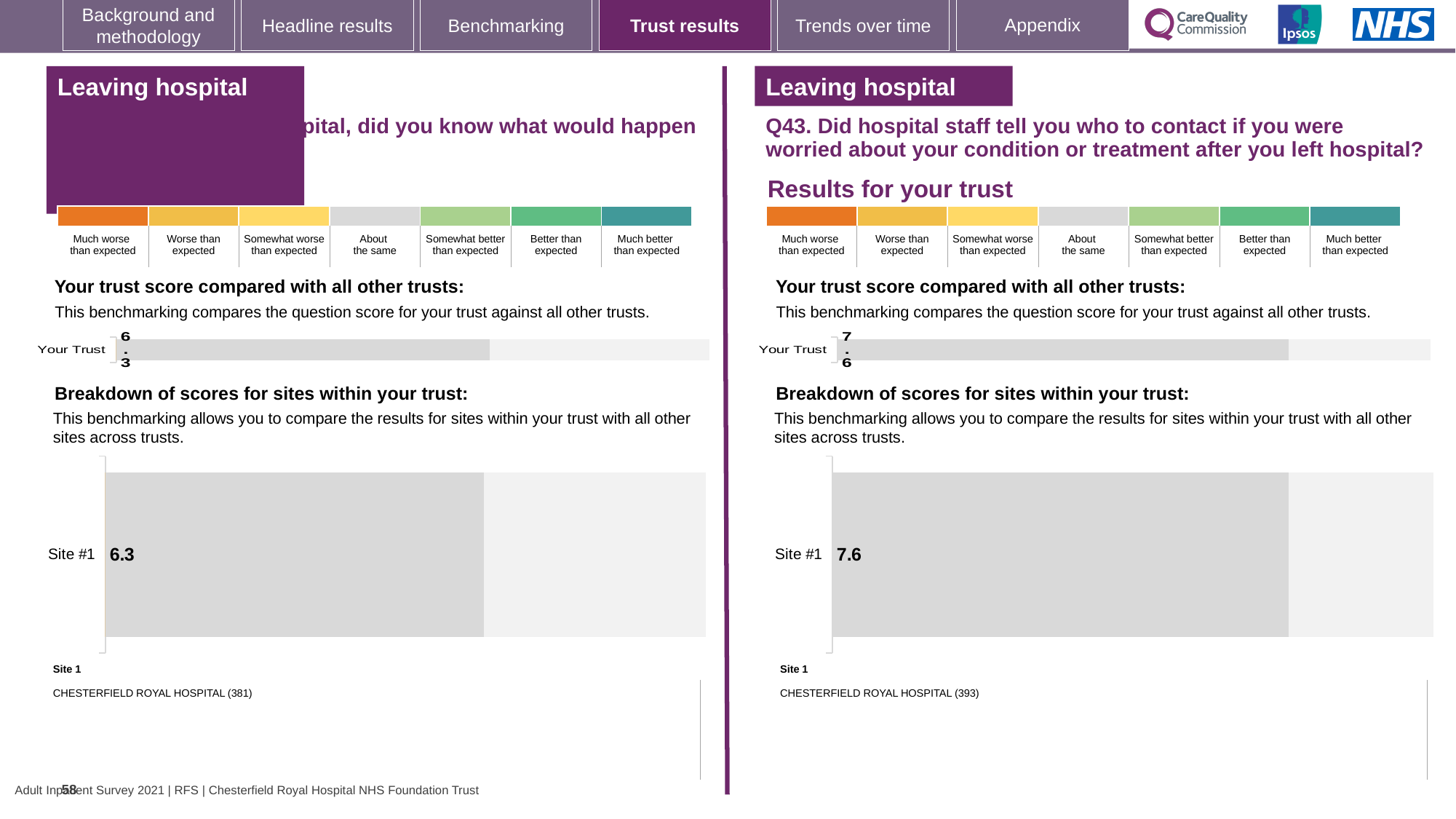
How many sites are shown in the left-hand 'Breakdown of scores for sites within your trust' chart? 1 On the left-hand side of the slide, what is the score shown for Your Trust? 6.3 Which is larger: the Site #1 score on the left-hand chart or the Site #1 score on the right-hand chart (Q43)? Right-hand chart (Q43) Which hospital is listed as Site 1 on the left-hand side of the slide? CHESTERFIELD ROYAL HOSPITAL (381) What type of chart is used to show the Your Trust score on the left-hand side of the slide? Bar chart In the left-hand 'Breakdown of scores for sites within your trust' chart, what is the score for Site #1? 6.3 On the right-hand side of the slide (Q43), what is the score shown for Your Trust? 7.6 In the right-hand 'Breakdown of scores for sites within your trust' chart (Q43), what is the score for Site #1? 7.6 What is the difference between the Site #1 score on the right-hand chart (Q43) and the Site #1 score on the left-hand chart? 1.3 How many sites are shown in the right-hand 'Breakdown of scores for sites within your trust' chart (Q43)? 1 What type of chart is used to show the Site #1 score on the right-hand side of the slide (Q43)? Bar chart Which hospital is listed as Site 1 on the right-hand side of the slide (Q43)? CHESTERFIELD ROYAL HOSPITAL (393)